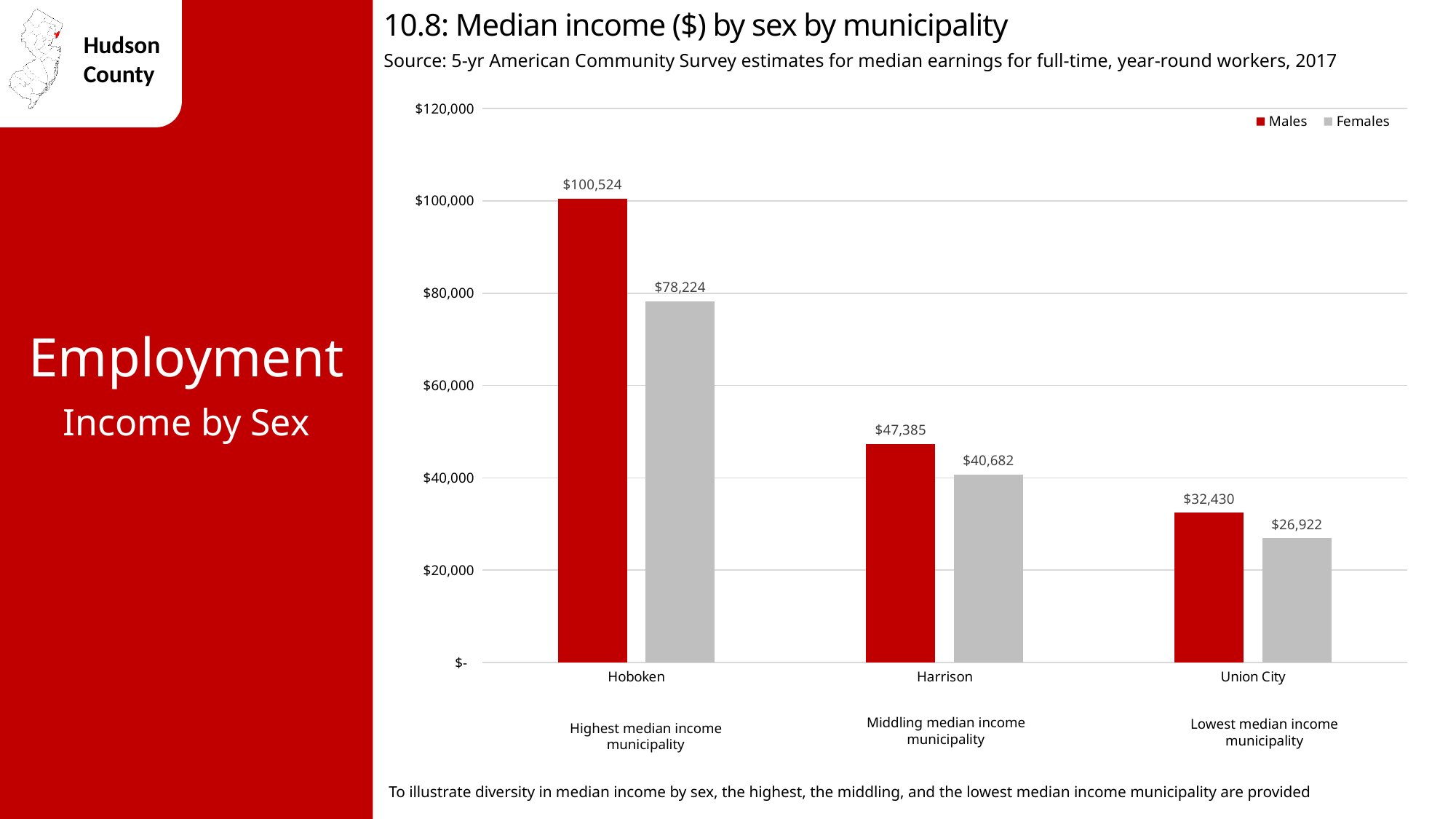
What is the median income for females in Harrison? $40,682 What kind of chart is shown on the slide? Bar chart How many municipalities are shown on the chart? 3 Which is larger: the female median income in Hoboken or the male median income in Harrison? Female median income in Hoboken Which municipality has the highest median income for males? Hoboken What is the difference between male and female median income in Hoboken? $22,300 What is the median income for males in Hoboken? $100,524 What is the difference between male and female median income in Union City? $5,508 How many series does the legend list? 2 Is the male median income in Harrison greater or less than $40,000? greater What is the median income for females in Union City? $26,922 Which municipality has the lowest median income for females? Union City